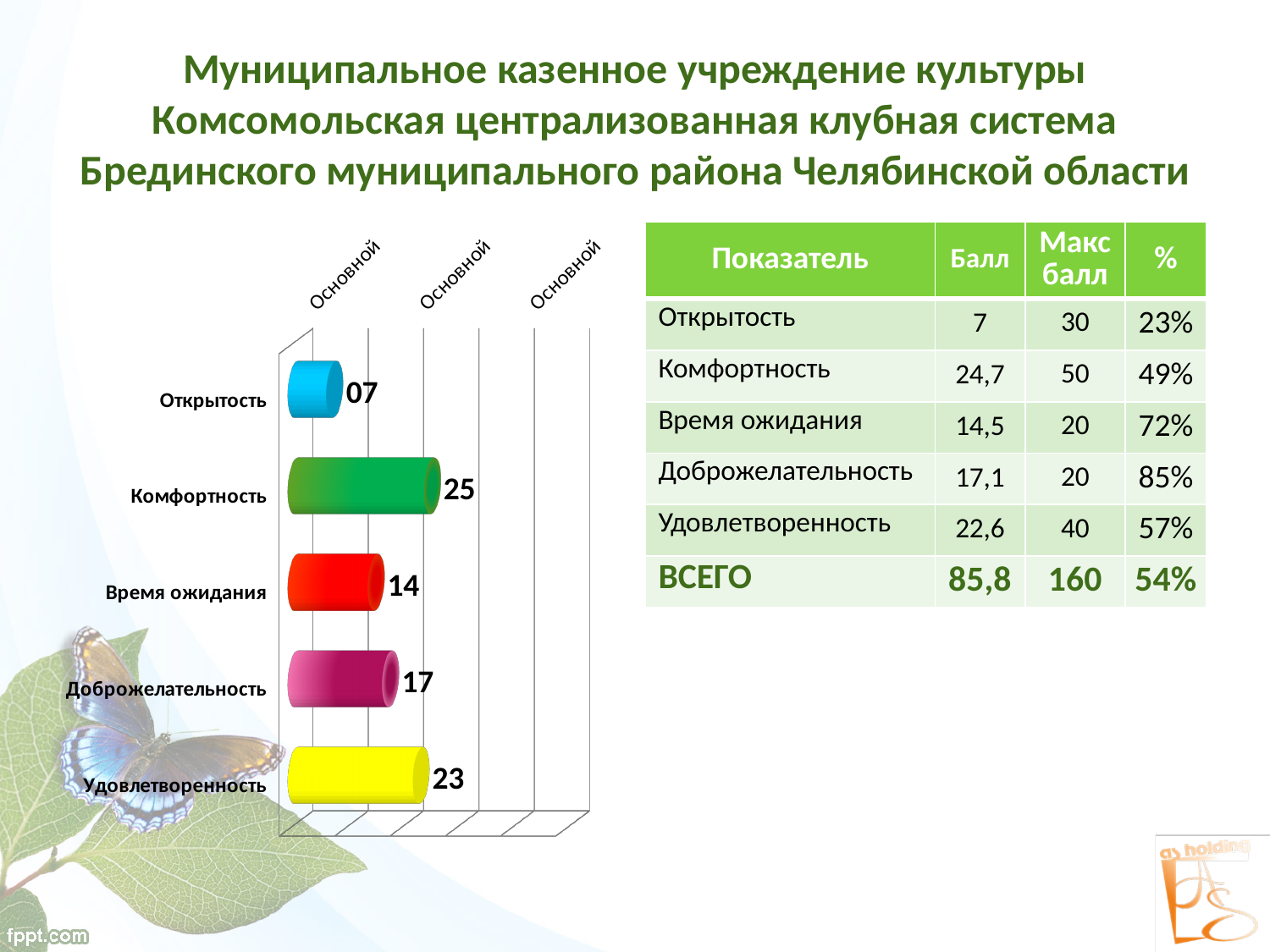
What is the difference between the values for Комфортность and Удовлетворенность in the chart? 2 What is the value shown for Доброжелательность in the chart? 17 What is the value shown for Время ожидания in the chart? 14 What is the value shown for Открытость in the chart? 07 Which category has the highest value in the chart? Комфортность Which is larger in the chart, the value for Доброжелательность or the value for Время ожидания? Доброжелательность How many categories are plotted in the chart? 5 Which category has the lowest value in the chart? Открытость What is the value shown for Комфортность in the chart? 25 What colour is the bar for Удовлетворенность in the chart? yellow What is the value shown for Удовлетворенность in the chart? 23 What type of chart is shown on the slide? bar chart